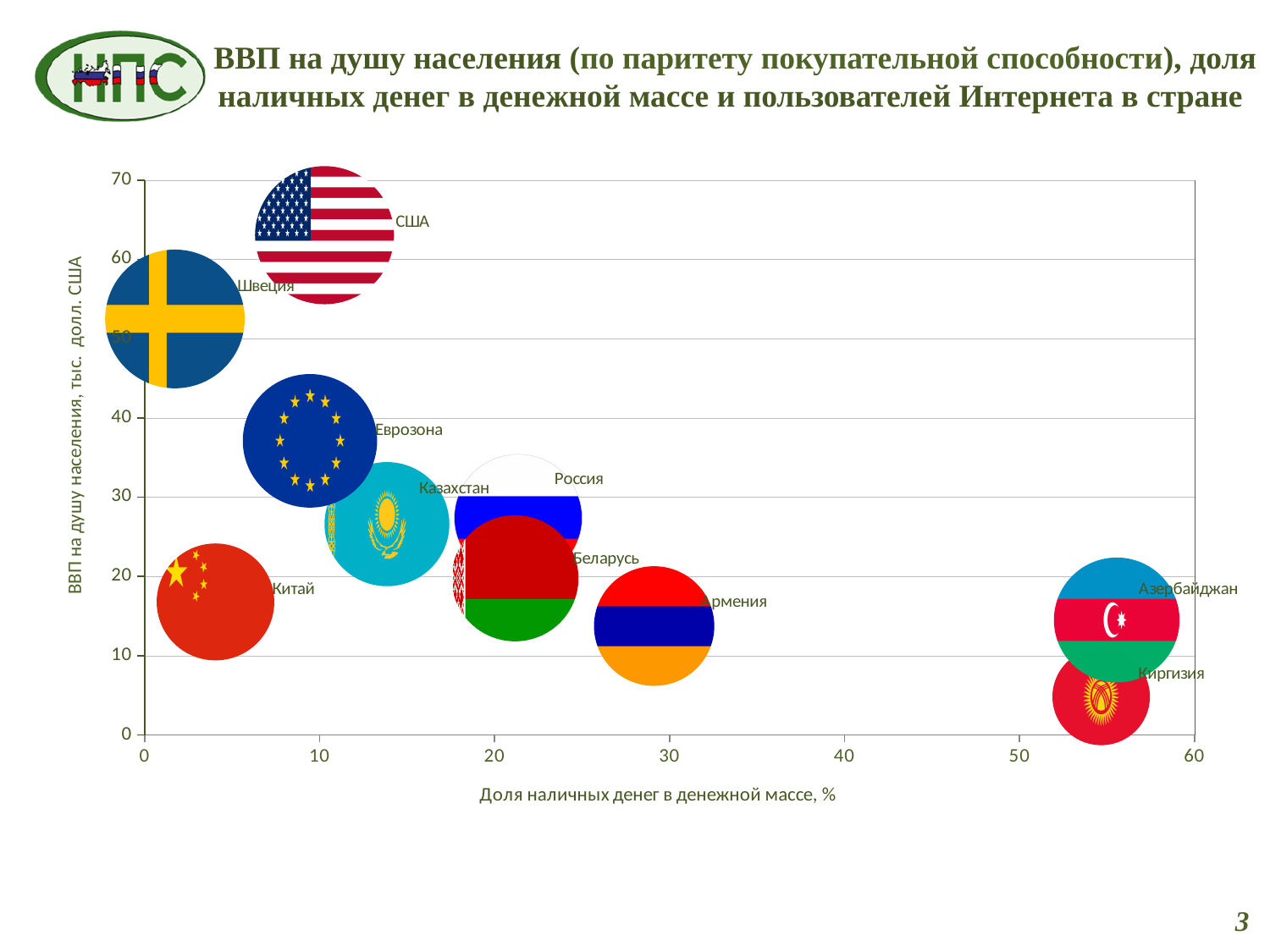
Which has the larger share of cash in money supply, Армения or Китай? Армения Is the GDP per capita value for Еврозона greater or less than 30? greater Is the GDP per capita value for Киргизия greater or less than 10? less How many countries or regions are plotted on the chart? 10 What is the title of the horizontal axis of the chart? Доля наличных денег в денежной массе, % Is the share of cash in money supply for Китай greater or less than 10? less Which country has the lowest GDP per capita (ВВП на душу населения) on the chart? Киргизия What kind of chart is shown on the slide? bubble chart Which has the higher GDP per capita, США or Китай? США Which country has the highest GDP per capita (ВВП на душу населения) on the chart? США